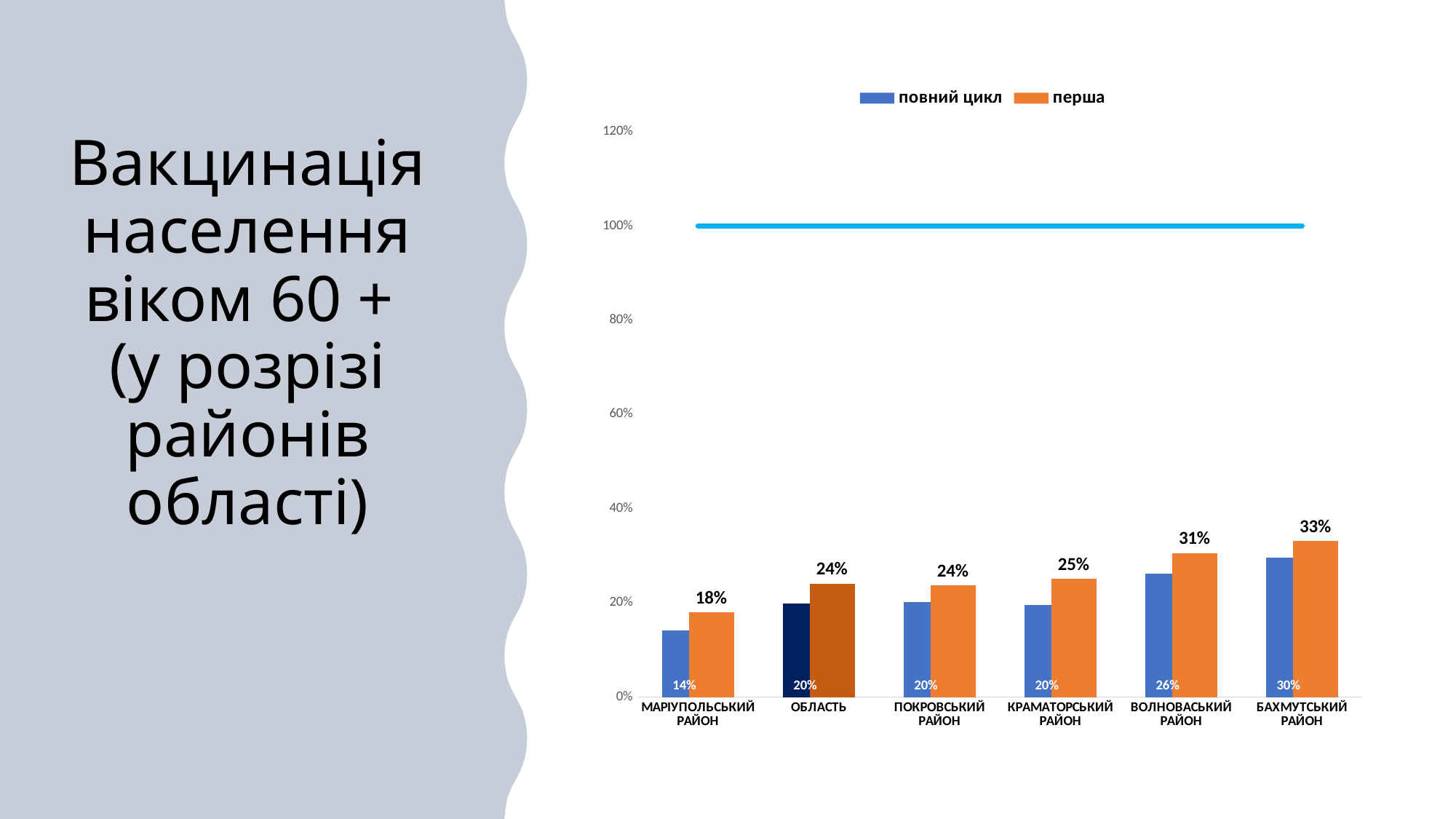
Which colour represents the "перша" series in the legend? orange Which is larger for Краматорський район: "повний цикл" or "перша"? перша Which category has the highest "повний цикл" value? Бахмутський район Is the "перша" value for Бахмутський район greater or less than 40%? less What kind of chart is shown on the slide? combination bar and line chart What is the value of "перша" for Область? 24% What is the value of "перша" for Бахмутський район? 33% How many categories are shown on the x axis? 6 What is the difference between the "перша" and "повний цикл" values for Волноваський район? 5% Which category has the lowest "перша" value? Маріупольський район What is the value of "повний цикл" for Маріупольський район? 14% How many series does the legend list? 2